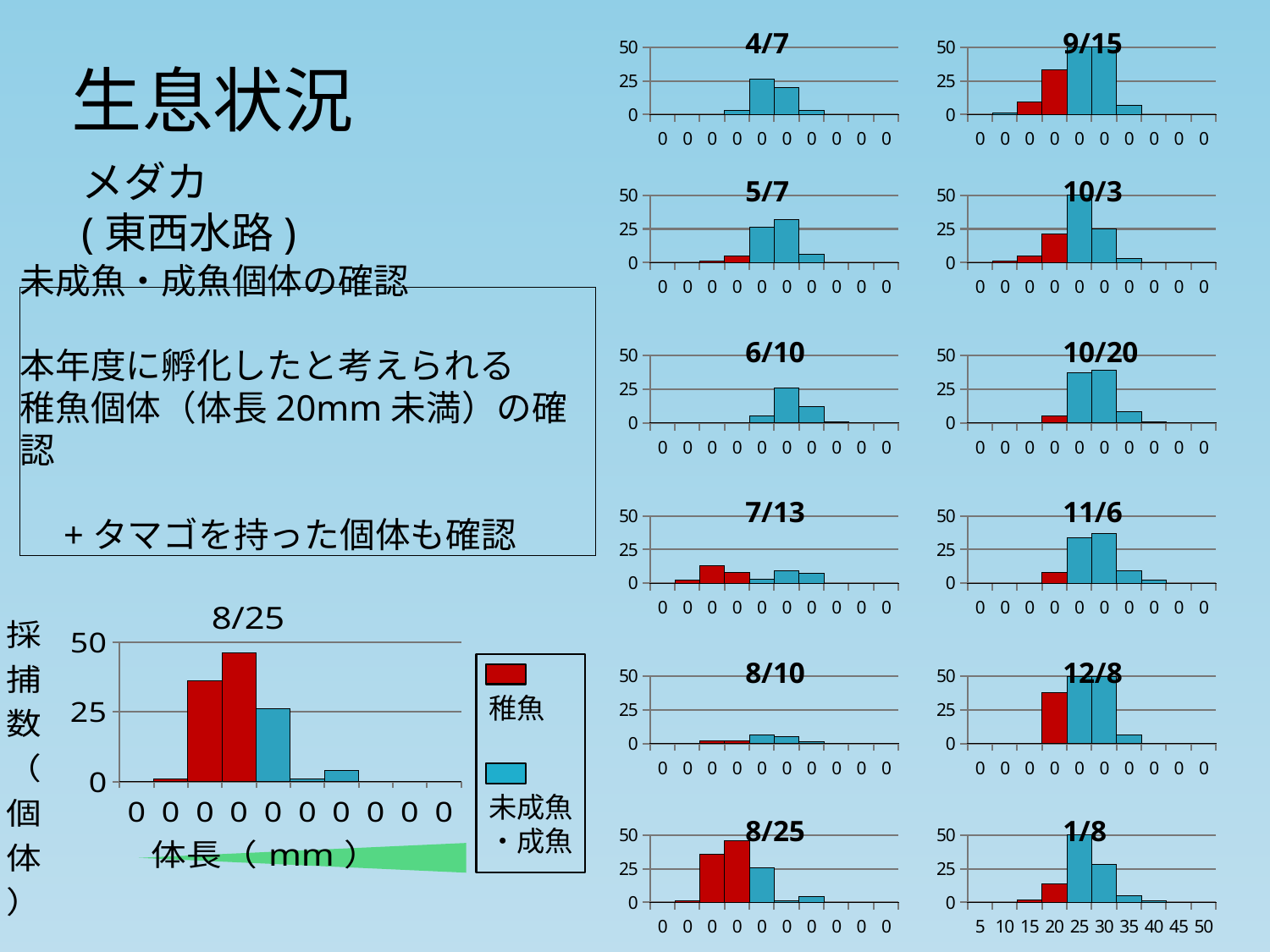
How many series does the legend next to the large 8/25 chart list? 2 In the legend next to the large 8/25 chart, which series is shown in red? 稚魚 In the chart titled 1/8, is the value for category 25 larger or smaller than the value for category 20? larger In the chart titled 7/13, is the tallest bar greater or less than 25? less In the legend next to the large 8/25 chart, which series is shown in blue? 未成魚・成魚 In the chart titled 8/10, is the tallest bar greater or less than 25? less In the chart titled 1/8, how many categories are labelled on the x axis? 10 In the chart titled 1/8, is the value for category 20 greater or less than 25? less What kind of chart is the large chart titled 8/25 on the left of the slide? bar chart In the chart titled 1/8, which x-axis category has the tallest bar? 25